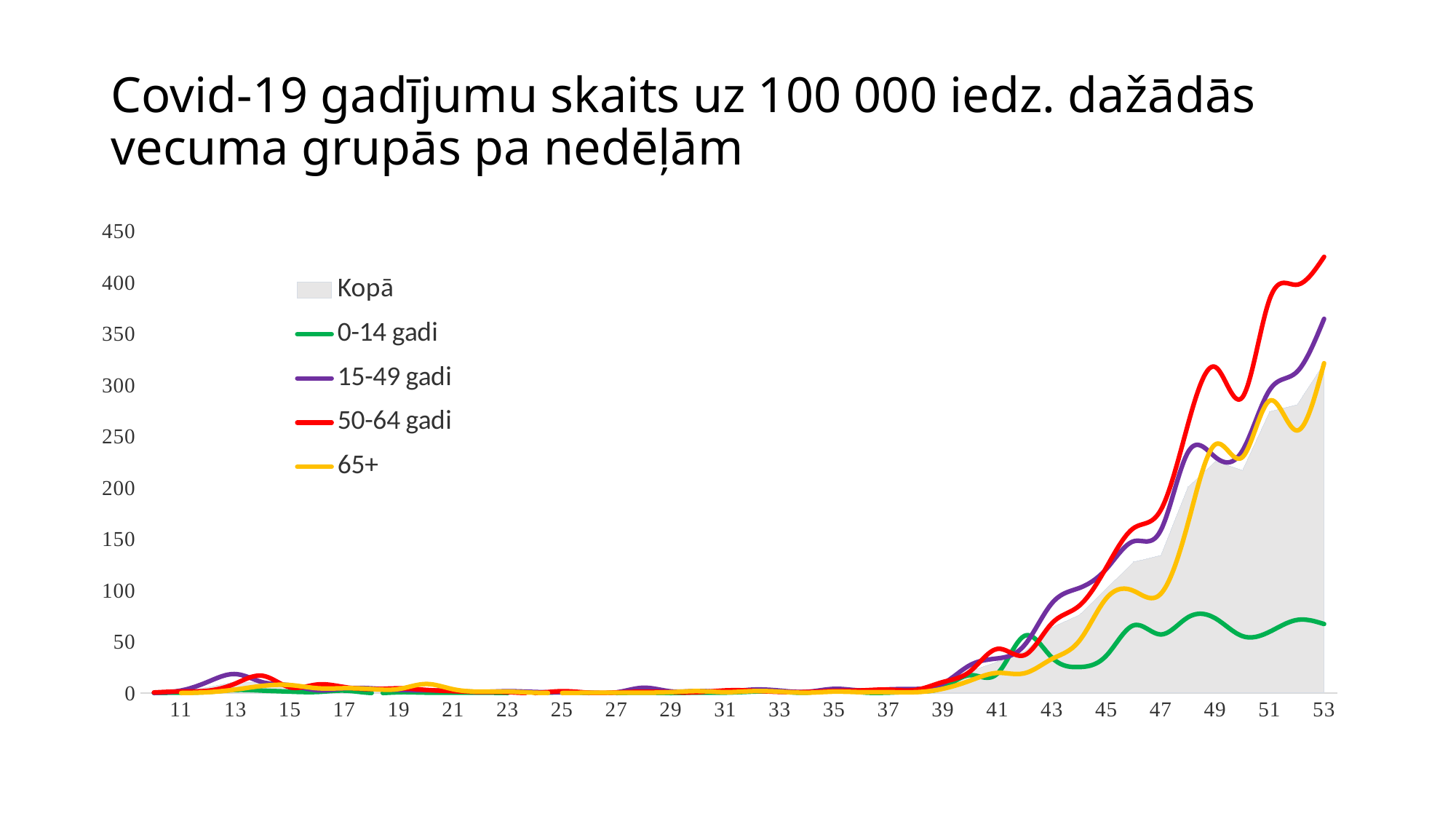
How many series does the legend list? 5 Which age group has the highest value at week 53? 50-64 gadi At week 47, which is larger: the value for 15-49 gadi or the value for 65+? 15-49 gadi Does the value for 50-64 gadi rise or fall from week 39 to week 53? rise Is the value for 65+ at week 53 greater or less than 300? greater What kind of chart is shown on the slide? combination area and line chart Is the value for 0-14 gadi at week 53 greater or less than 100? less Which series is shown as a shaded grey area rather than a line? Kopā Which age group has the lowest value at week 53? 0-14 gadi What is the title of the chart? Covid-19 gadījumu skaits uz 100 000 iedz. dažādās vecuma grupās pa nedēļām Is the value for 50-64 gadi at week 53 greater or less than 400? greater At week 53, which is larger: the value for 15-49 gadi or the value for 65+? 15-49 gadi